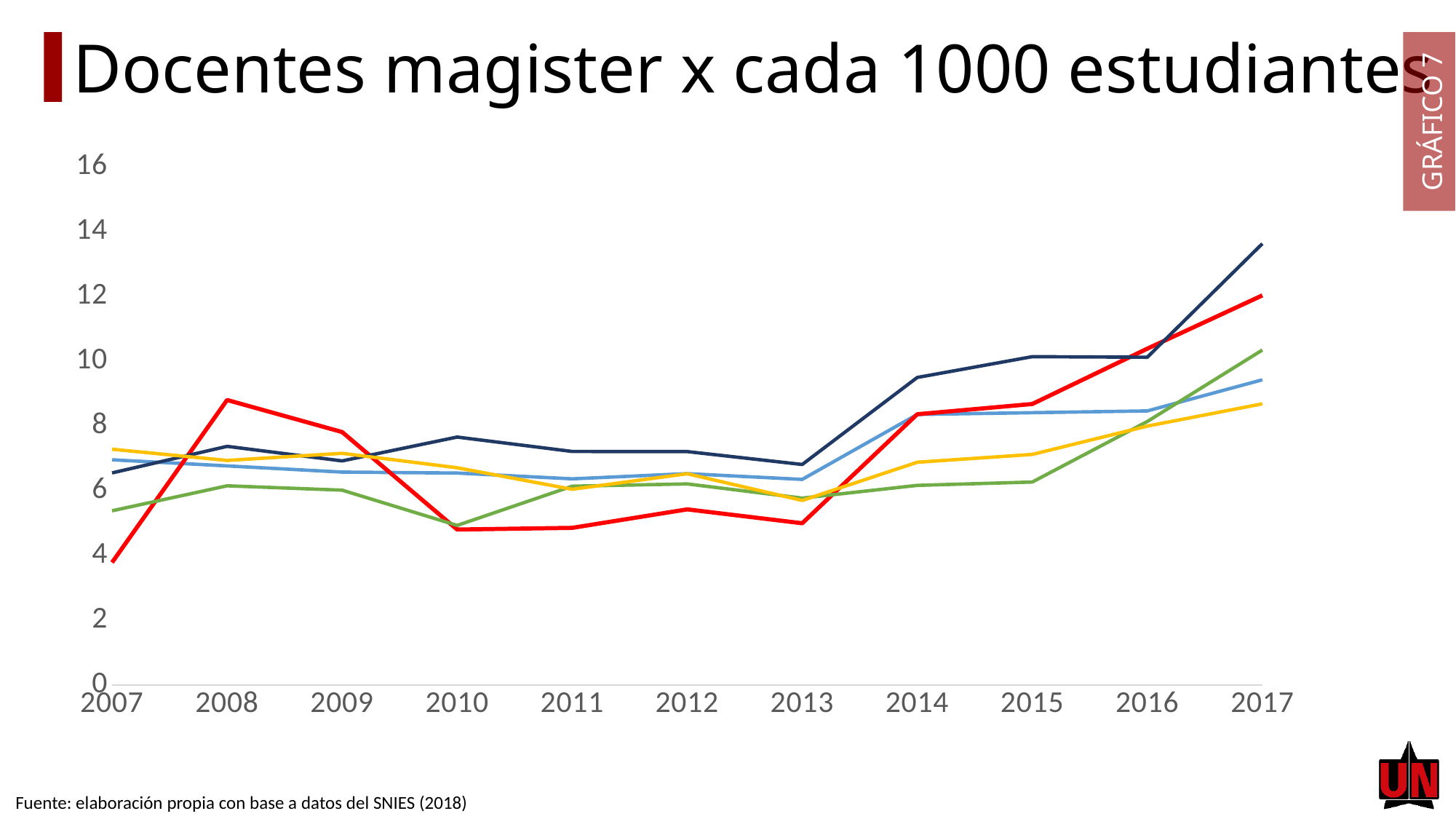
Is the value of the red line in 2010 greater or less than 6? less Which line has the lowest value in 2007? the red line Which line has the highest value in 2017? the dark blue line What is the title of the chart? Docentes magister x cada 1000 estudiantes Is the value of the red line in 2008 greater or less than 8? greater Is the value of the dark blue line in 2017 greater or less than 12? greater Does the dark blue line rise or fall from 2013 to 2017? rise How many years are shown along the x axis of the chart? 11 How many lines are plotted on the chart? 5 What kind of chart is shown on the slide? line chart